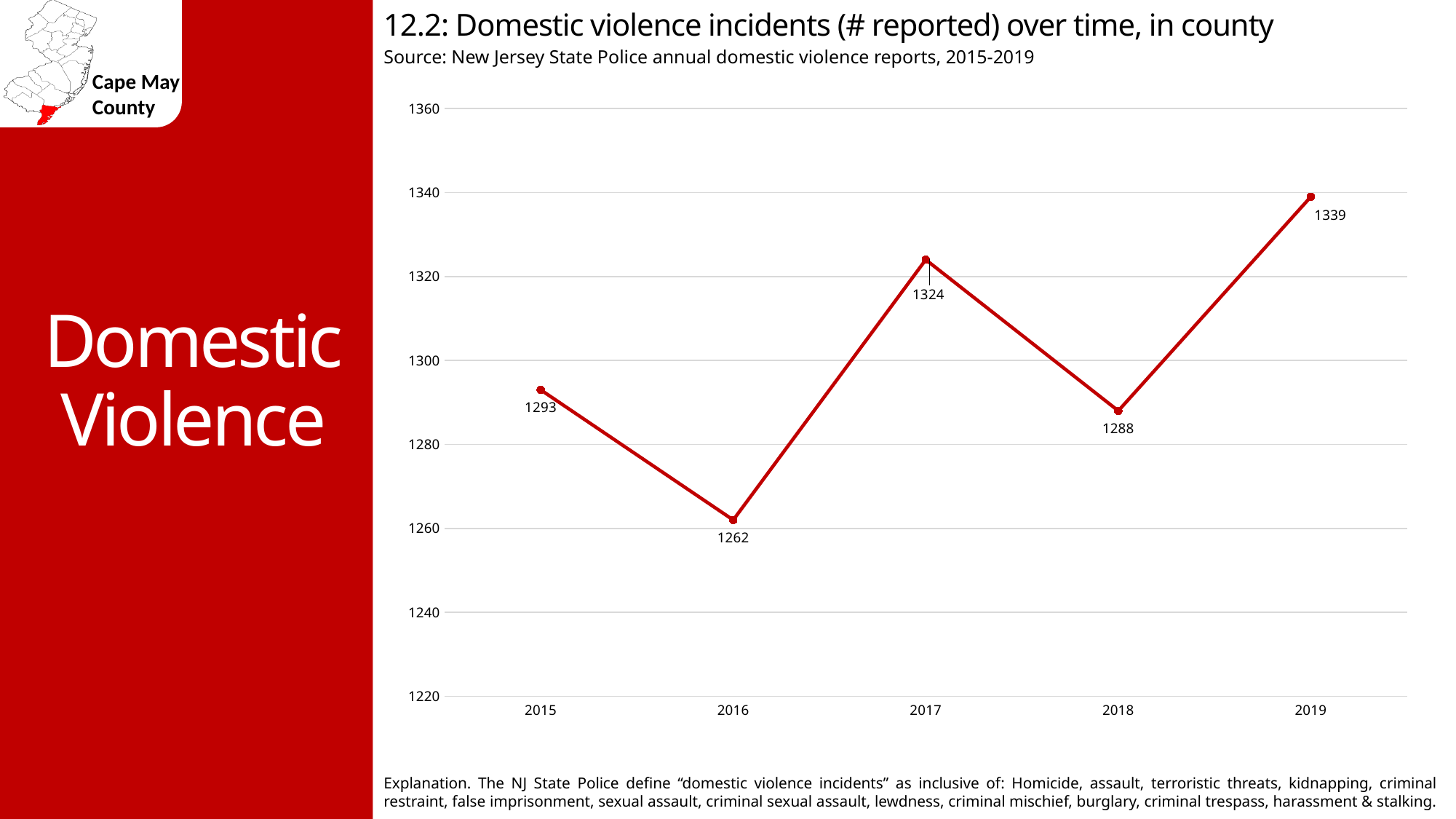
How many domestic violence incidents were reported in 2017? 1324 Were more domestic violence incidents reported in 2015 or in 2018? 2015 Is the value for 2017 greater or less than 1320? greater What is the source of the data shown in the chart? New Jersey State Police annual domestic violence reports, 2015-2019 Which year had the highest number of reported domestic violence incidents? 2019 What was the number of reported domestic violence incidents in 2016? 1262 How many years are plotted on the chart? 5 By how much did reported incidents fall from 2015 to 2016? 31 What is the difference between the number of incidents reported in 2019 and in 2018? 51 What type of chart is used to show domestic violence incidents over time? line chart Did the number of reported incidents rise or fall from 2018 to 2019? rise Which year had the lowest number of reported domestic violence incidents? 2016